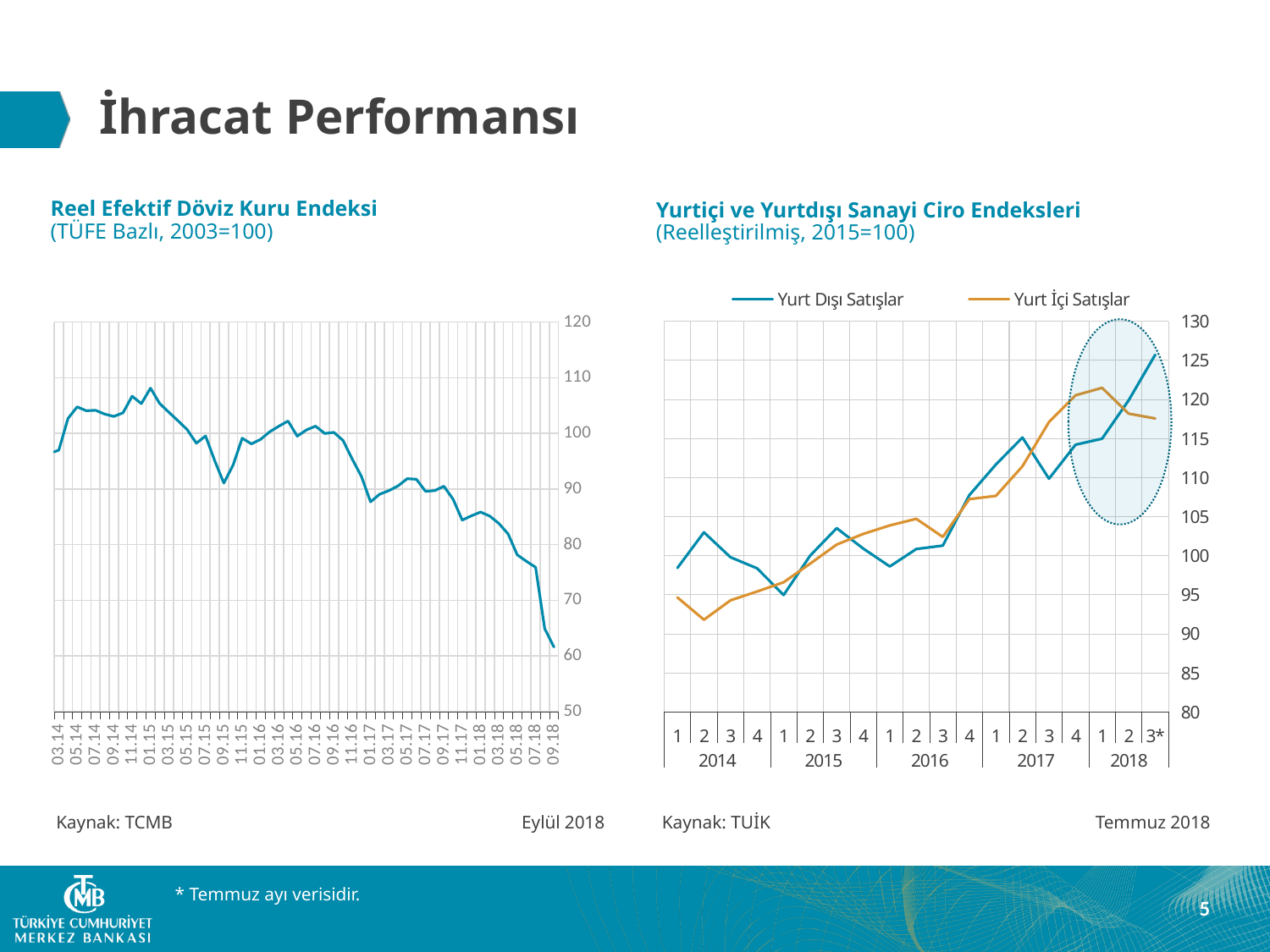
In the right chart, Yurtiçi ve Yurtdışı Sanayi Ciro Endeksleri, is the Yurt İçi Satışlar value for 2014 quarter 2 greater or less than 95? less In the left chart, Reel Efektif Döviz Kuru Endeksi, which is larger: the value for 01.15 or the value for 09.18? 01.15 How many series does the legend of the right chart, Yurtiçi ve Yurtdışı Sanayi Ciro Endeksleri, list? 2 In the left chart, Reel Efektif Döviz Kuru Endeksi, do the values overall rise or fall from 03.14 to 09.18? fall In the right chart, Yurtiçi ve Yurtdışı Sanayi Ciro Endeksleri, in which period does Yurt Dışı Satışlar reach its highest value? 2018 quarter 3* What source is given for the right chart, Yurtiçi ve Yurtdışı Sanayi Ciro Endeksleri? TUİK In the left chart, Reel Efektif Döviz Kuru Endeksi, is the value for 01.15 greater or less than 100? greater In the right chart, Yurtiçi ve Yurtdışı Sanayi Ciro Endeksleri, which series is higher in 2018 quarter 3*: Yurt Dışı Satışlar or Yurt İçi Satışlar? Yurt Dışı Satışlar In the right chart, Yurtiçi ve Yurtdışı Sanayi Ciro Endeksleri, is the Yurt Dışı Satışlar value for 2018 quarter 3* greater or less than 120? greater How many quarterly points are plotted along the x axis of the right chart, Yurtiçi ve Yurtdışı Sanayi Ciro Endeksleri? 19 What kind of chart is the left chart, Reel Efektif Döviz Kuru Endeksi? line chart